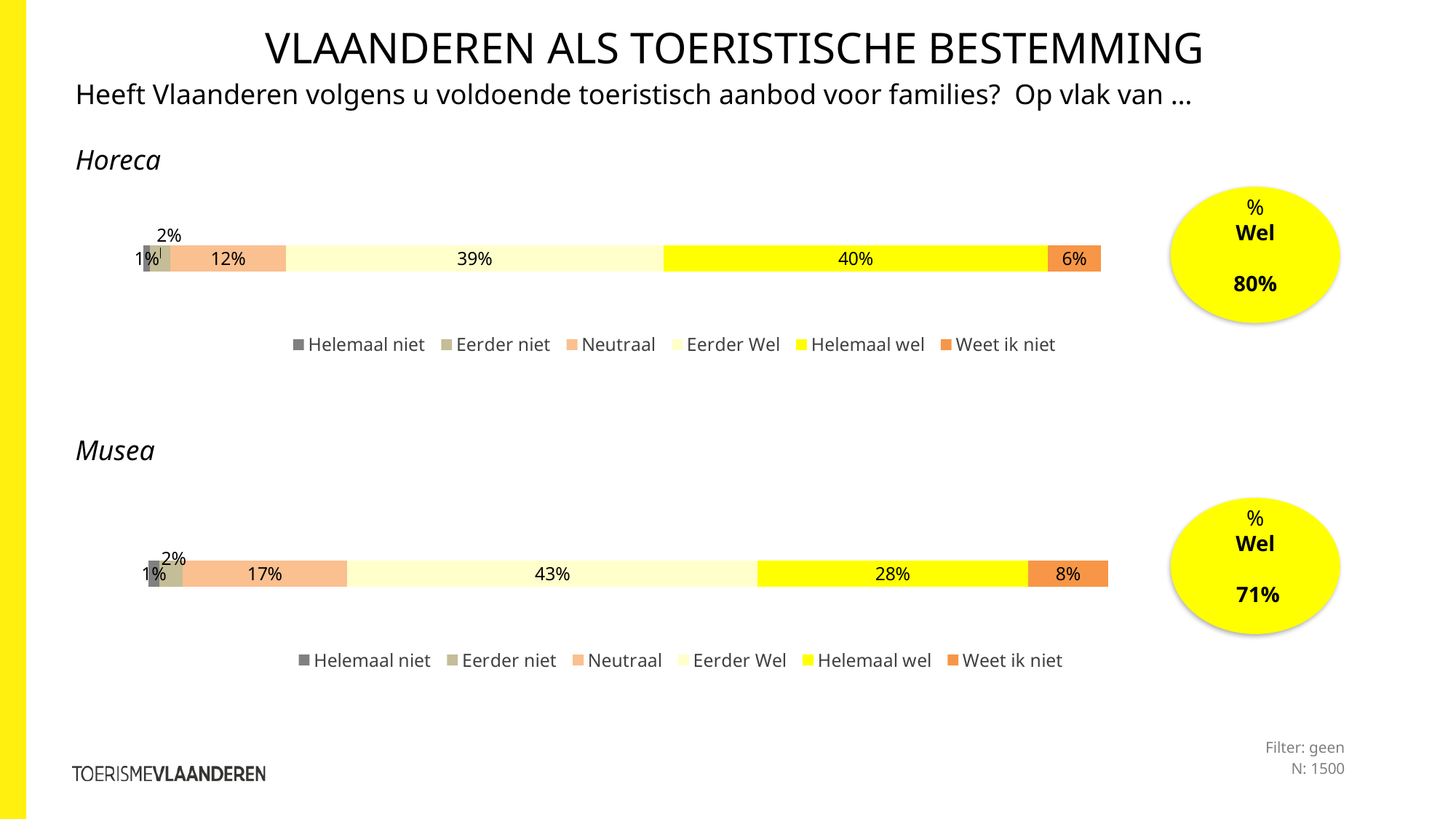
What is the difference between the Neutraal percentages in the Musea chart and the Horeca chart? 5% What is the total of the Horeca stacked bar? 100% How many series does the legend of the Horeca chart list? 6 In the Musea chart, what percentage is shown for Weet ik niet? 8% What '% Wel' value is shown in the yellow circle next to the Musea chart? 71% In the Musea chart, what percentage is shown for Eerder Wel? 43% In the Horeca chart, what percentage is shown for Neutraal? 12% In the Horeca chart, which response category has the lowest percentage? Helemaal niet Which is larger: Helemaal wel in the Horeca chart or Helemaal wel in the Musea chart? Horeca In the Horeca chart, what percentage is shown for Helemaal wel? 40% In the Musea chart, which response category has the highest percentage? Eerder Wel What kind of chart is used for the Musea data? Stacked bar chart